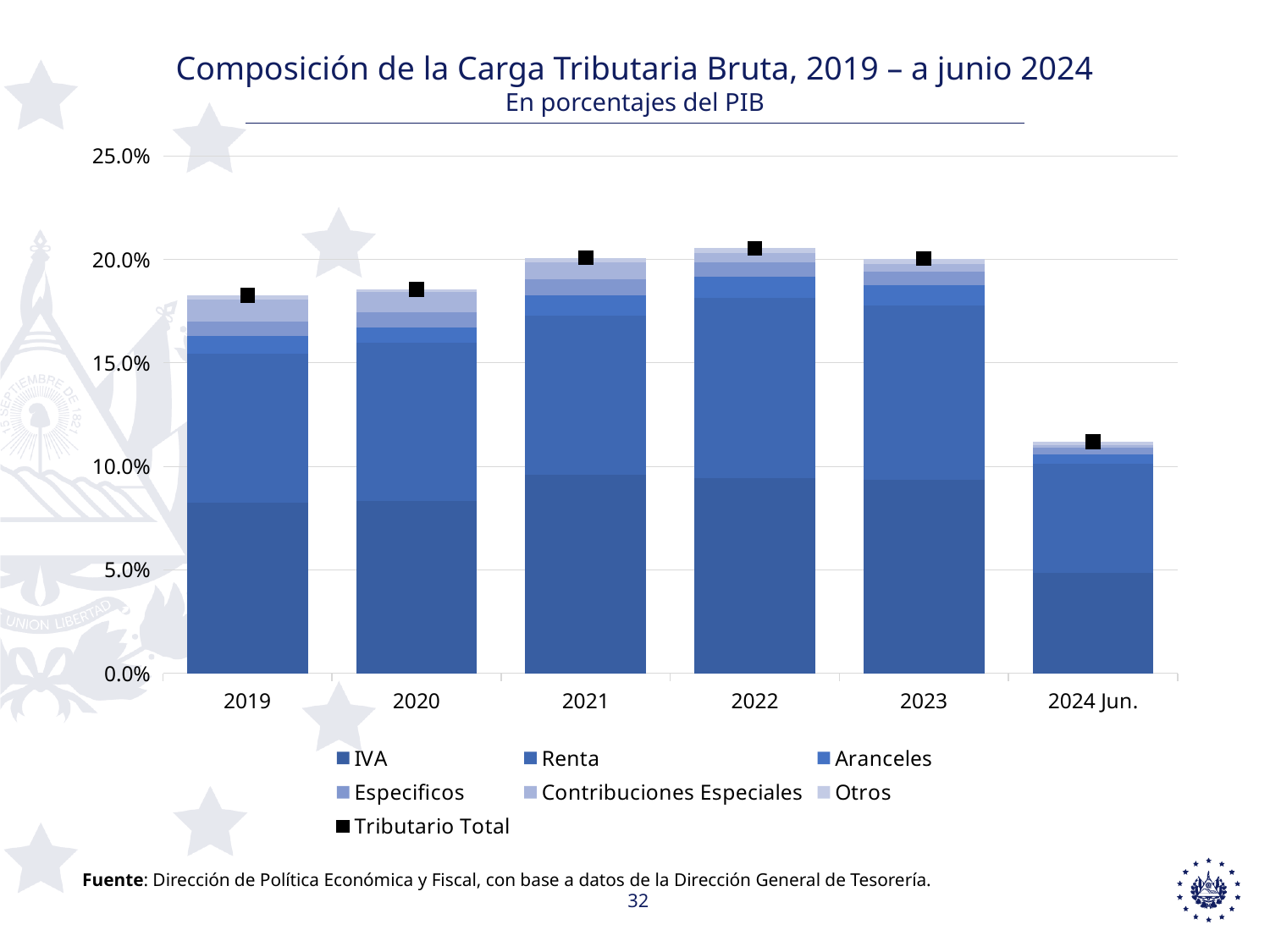
Which has a larger total tax burden, 2021 or 2019? 2021 Is the Tributario Total value for 2024 Jun. greater or less than 10.0%? greater Which period has the lowest total tax burden (Tributario Total) in the chart? 2024 Jun. Is the Tributario Total value for 2022 greater or less than 15.0%? greater How many entries does the chart legend list? 7 Is the Tributario Total value for 2019 greater or less than 20.0%? less Does the total tax burden rise or fall from 2019 to 2022? rise How many years/periods are shown on the x axis of the chart? 6 What kind of chart is shown on the slide? Stacked bar chart What is the subtitle of the chart, indicating the unit of measurement? En porcentajes del PIB Which year has the highest total tax burden (Tributario Total) in the chart? 2022